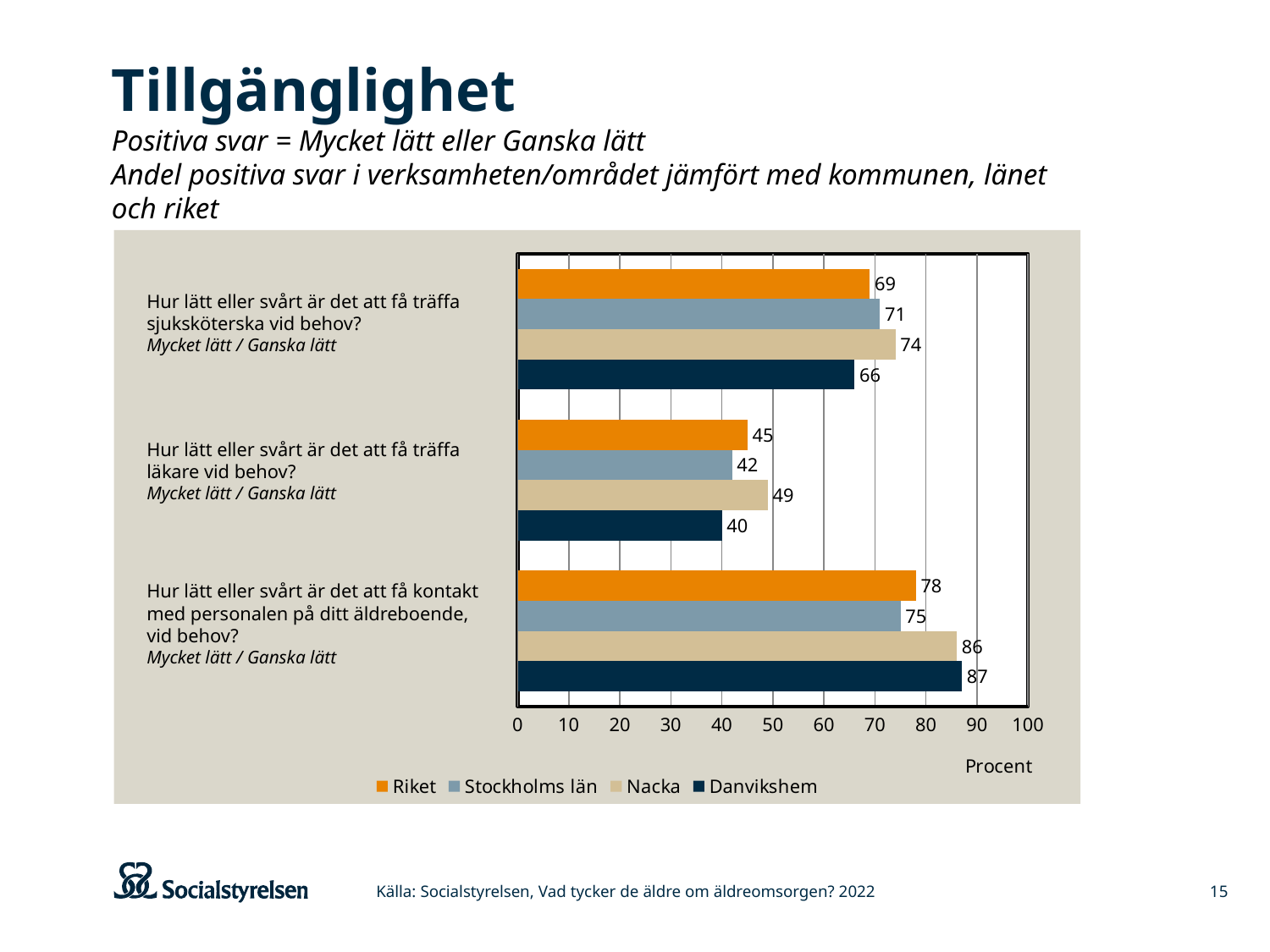
What is the value for Nacka on the question about meeting a nurse (sjuksköterska) when needed? 74 Which series has the highest value on the question about getting in contact with staff at the äldreboende? Danvikshem What is the difference between Nacka and Danvikshem on the question about meeting a nurse (sjuksköterska) when needed? 8 How many series does the legend list? 4 What is the value for Stockholms län on the question about meeting a doctor (läkare) when needed? 42 What is the value for Riket on the question about getting in contact with staff at the äldreboende? 78 What is the value for Danvikshem on the question about meeting a doctor (läkare) when needed? 40 What unit label is shown below the x axis of the chart? Procent Which is larger on the question about meeting a doctor (läkare): the value for Riket or the value for Nacka? Nacka Which series has the lowest value on the question about meeting a nurse (sjuksköterska) when needed? Danvikshem What kind of chart is shown on the slide? Bar chart How many question categories are shown on the chart? 3